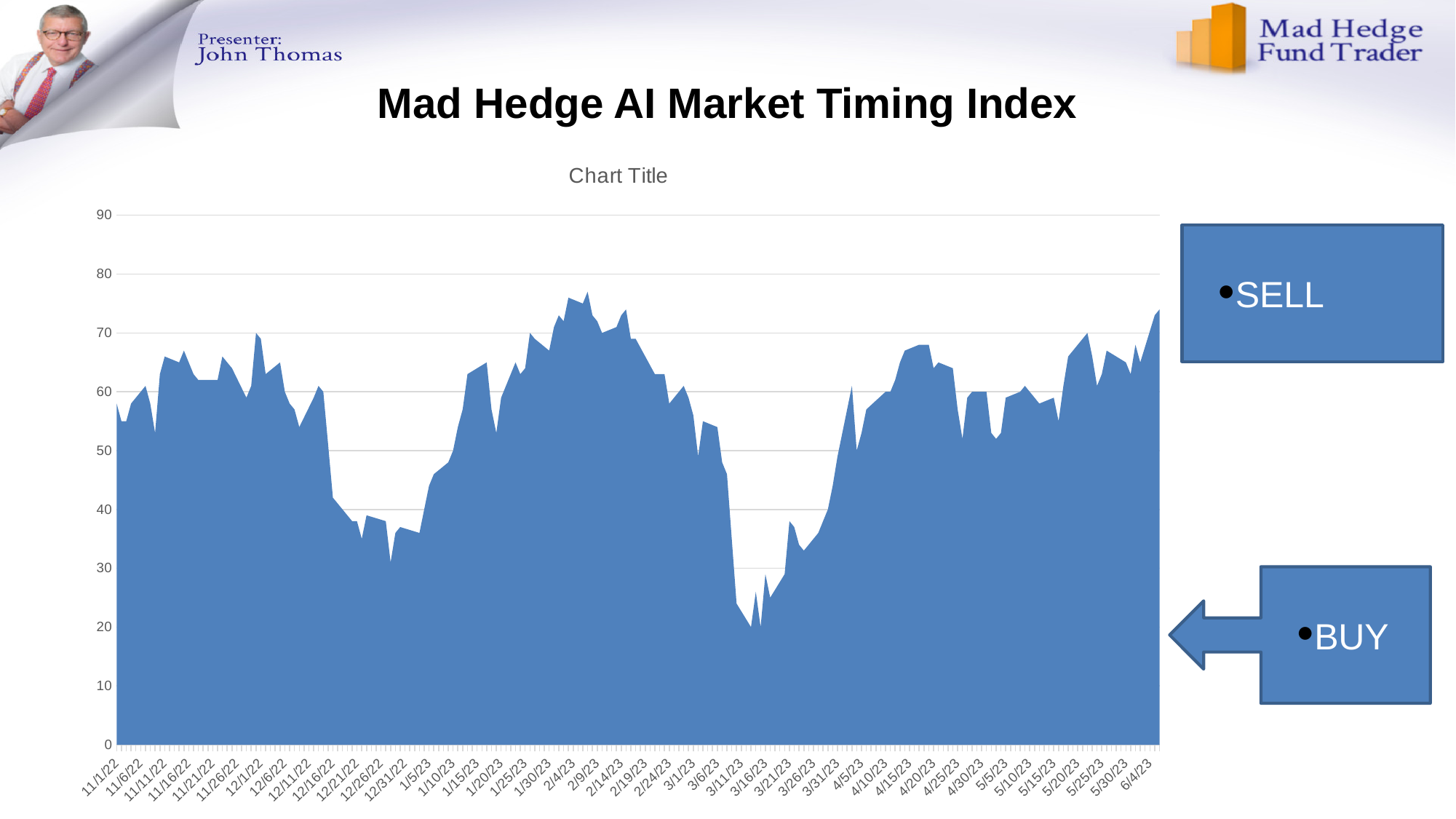
Do the values rise or fall between 2/9/23 and 3/16/23? fall What is the highest value labelled on the vertical axis? 90 Is the value for 11/1/22 greater or less than 50? greater Is the value for 12/26/22 greater or less than 50? less Which is larger, the value for 12/26/22 or the value for 4/20/23? 4/20/23 Which is larger, the value for 2/9/23 or the value for 3/16/23? 2/9/23 What kind of chart is shown on the slide? Area chart What is the title printed above the chart? Chart Title Is the value for 4/20/23 greater or less than 60? greater